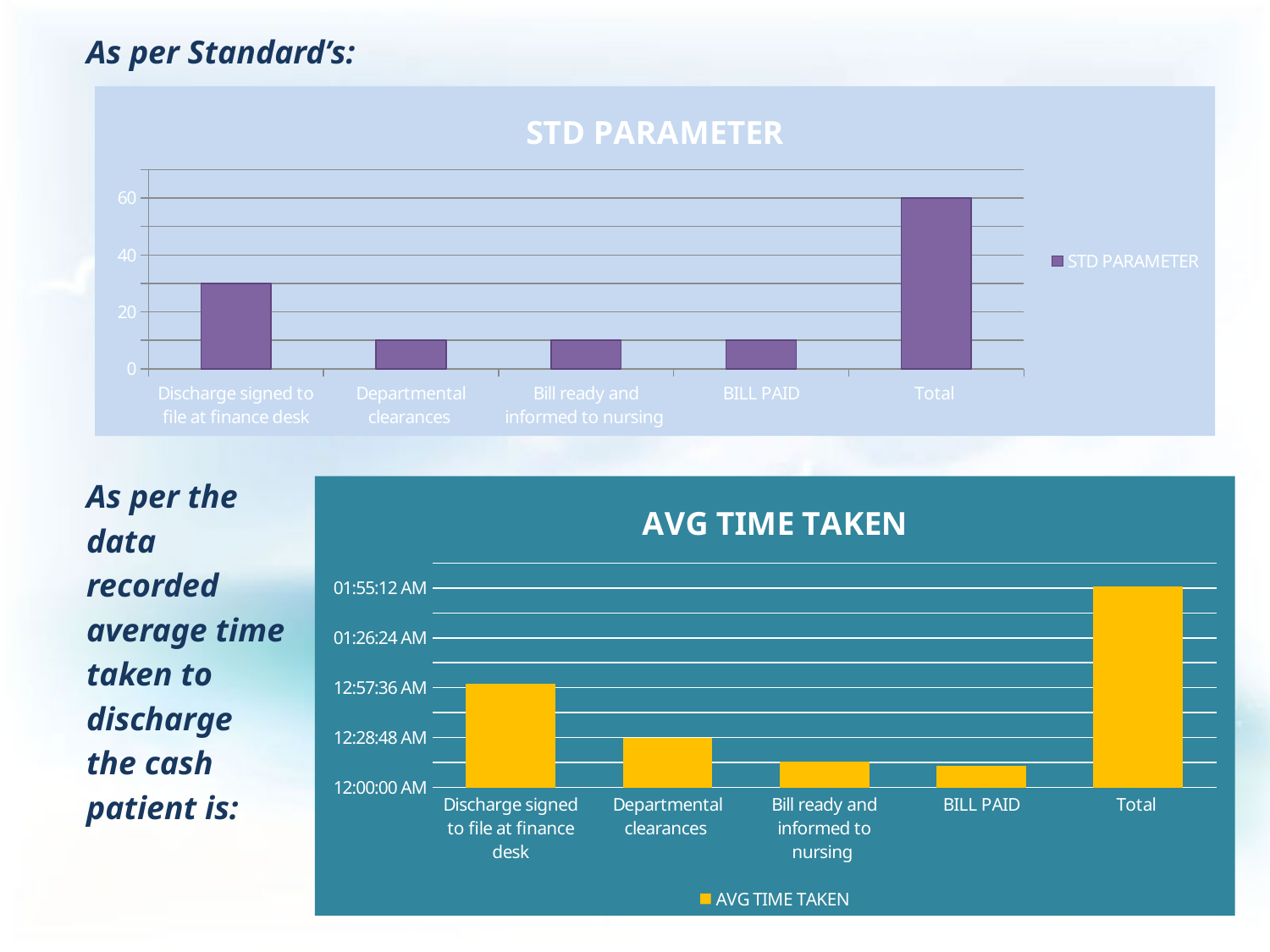
How many series does the legend of the AVG TIME TAKEN chart list? 1 In the AVG TIME TAKEN chart, which category has the highest value? Total In the STD PARAMETER chart, is the value for Departmental clearances greater or less than 20? less In the AVG TIME TAKEN chart, which is larger, the value for Discharge signed to file at finance desk or the value for Departmental clearances? Discharge signed to file at finance desk In the STD PARAMETER chart, which category has the highest value? Total How many categories are shown in the STD PARAMETER chart? 5 In the AVG TIME TAKEN chart, is the value for BILL PAID greater or less than 12:28:48 AM? less In the STD PARAMETER chart, which is larger, the value for Discharge signed to file at finance desk or the value for BILL PAID? Discharge signed to file at finance desk In the AVG TIME TAKEN chart, is the value for Discharge signed to file at finance desk greater or less than 12:28:48 AM? greater In the STD PARAMETER chart, what is the value for Total? 60 What kind of chart is the AVG TIME TAKEN chart? Bar chart